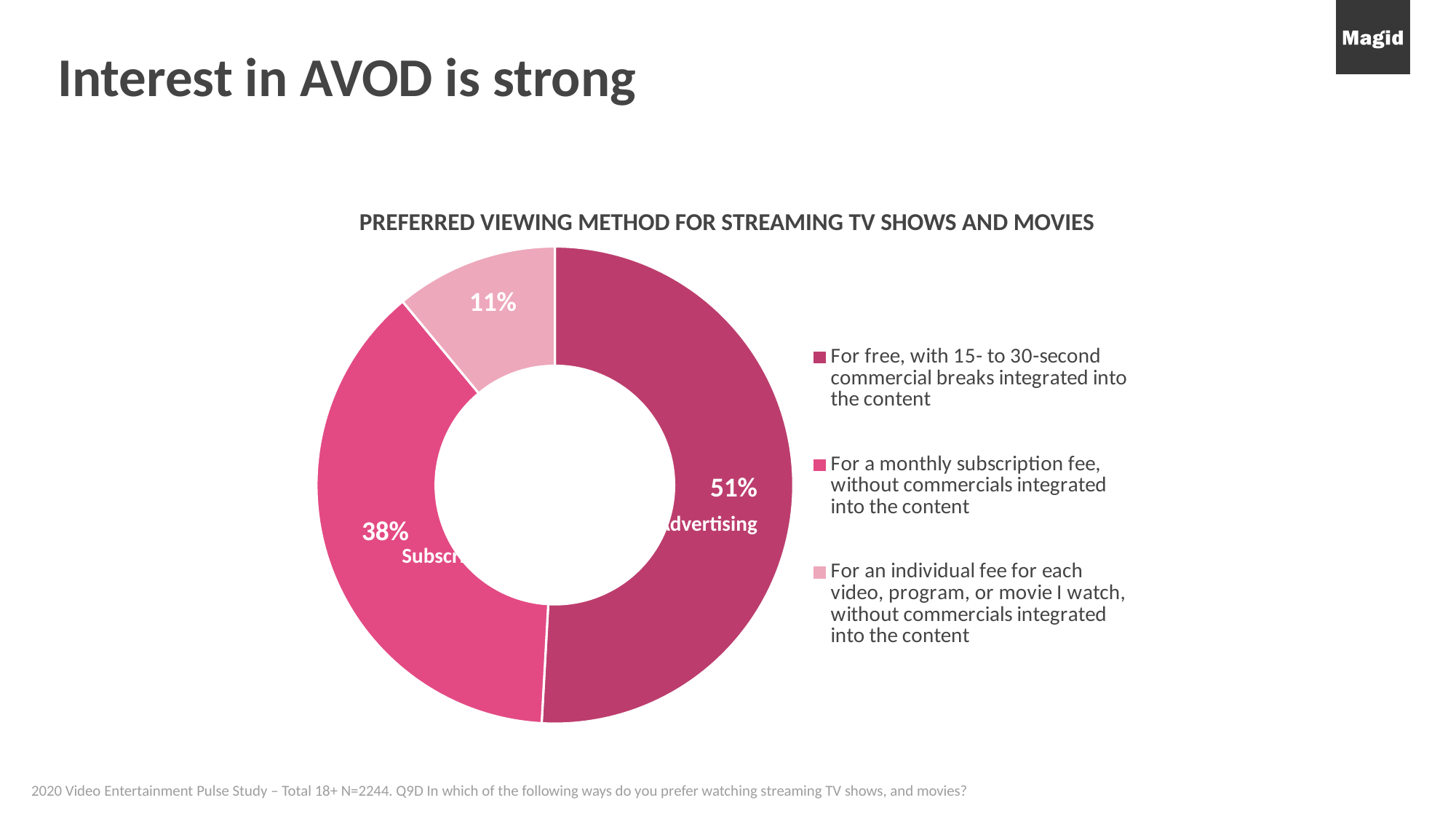
What is the difference in percentage points between the free-with-commercials share and the monthly subscription share? 13 percentage points Which slice is shown in the lightest pink colour? For an individual fee for each video, program, or movie I watch, without commercials integrated into the content How many viewing methods are shown in the chart? 3 Which is larger: the share preferring a monthly subscription fee or the share preferring an individual fee per video? Monthly subscription fee What share of respondents prefer watching for a monthly subscription fee, without commercials integrated into the content? 38% What is the difference in percentage points between the monthly subscription share and the individual fee share? 27 percentage points What is the title of the chart? PREFERRED VIEWING METHOD FOR STREAMING TV SHOWS AND MOVIES What kind of chart is shown on the slide? Pie chart (donut) Which viewing method has the largest share in the chart? For free, with 15- to 30-second commercial breaks integrated into the content What share of respondents prefer watching for free, with 15- to 30-second commercial breaks integrated into the content? 51% Which viewing method has the smallest share in the chart? For an individual fee for each video, program, or movie I watch, without commercials integrated into the content What share of respondents prefer paying an individual fee for each video, program, or movie they watch? 11%